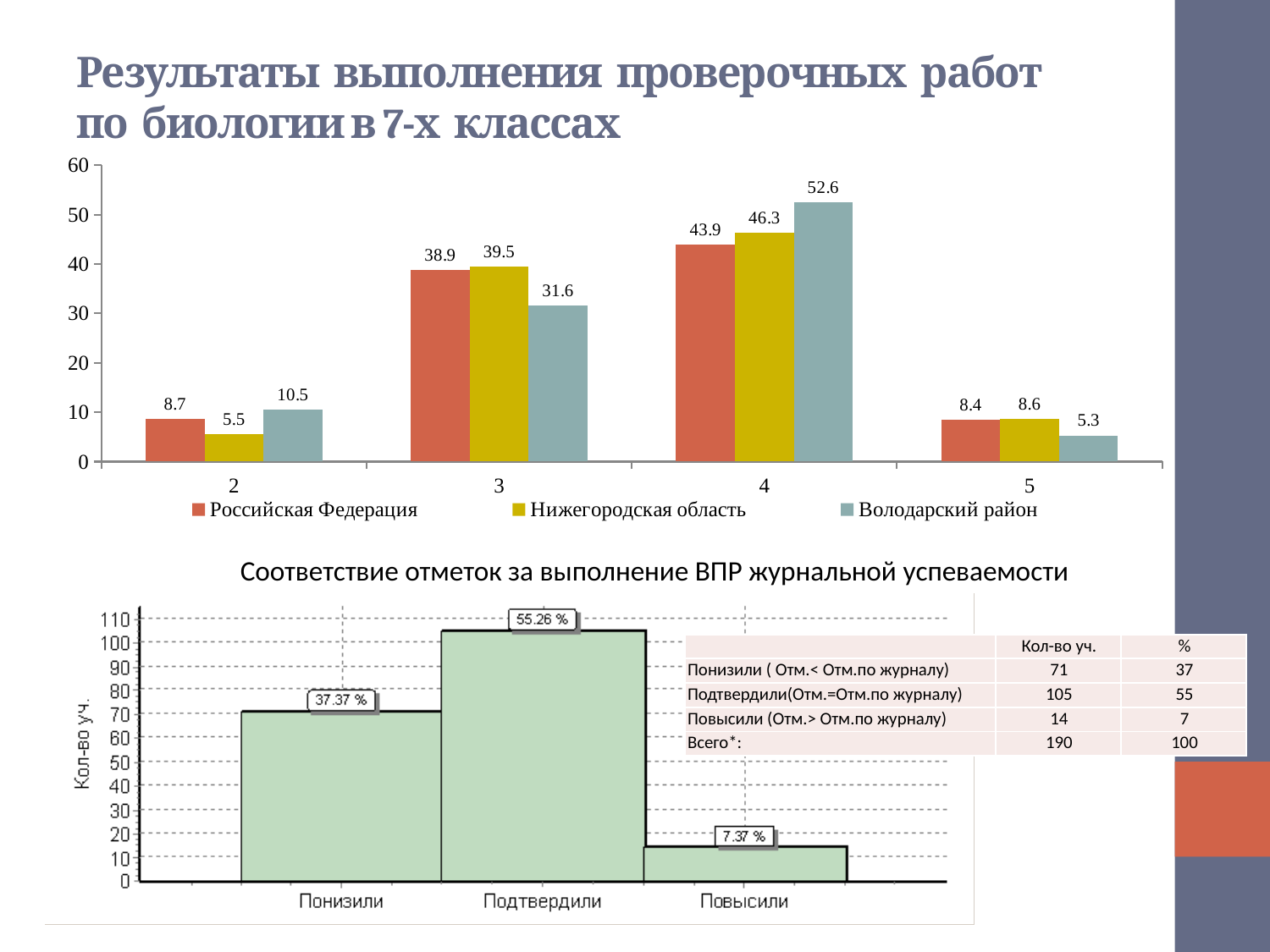
How many grade categories are shown on the x axis of the top chart? 4 In the top chart, which is larger for grade 3: Нижегородская область or Володарский район? Нижегородская область What kind of chart is the bottom chart (Соответствие отметок за выполнение ВПР журнальной успеваемости)? bar chart In the bottom chart (Соответствие отметок за выполнение ВПР журнальной успеваемости), what percentage is shown for Подтвердили? 55.26 % In the top chart, what is the value for Нижегородская область for grade 2? 5.5 In the top chart, which grade has the highest value for Володарский район? 4 In the top chart, what is the difference between Володарский район and Российская Федерация for grade 4? 8.7 In the top chart, what is the value for Российская Федерация for grade 3? 38.9 How many series does the legend of the top chart list? 3 In the top chart, what is the value for Володарский район for grade 4? 52.6 In the bottom chart (Соответствие отметок за выполнение ВПР журнальной успеваемости), which category has the lowest bar? Повысили In the top chart, which grade has the lowest value for Нижегородская область? 2